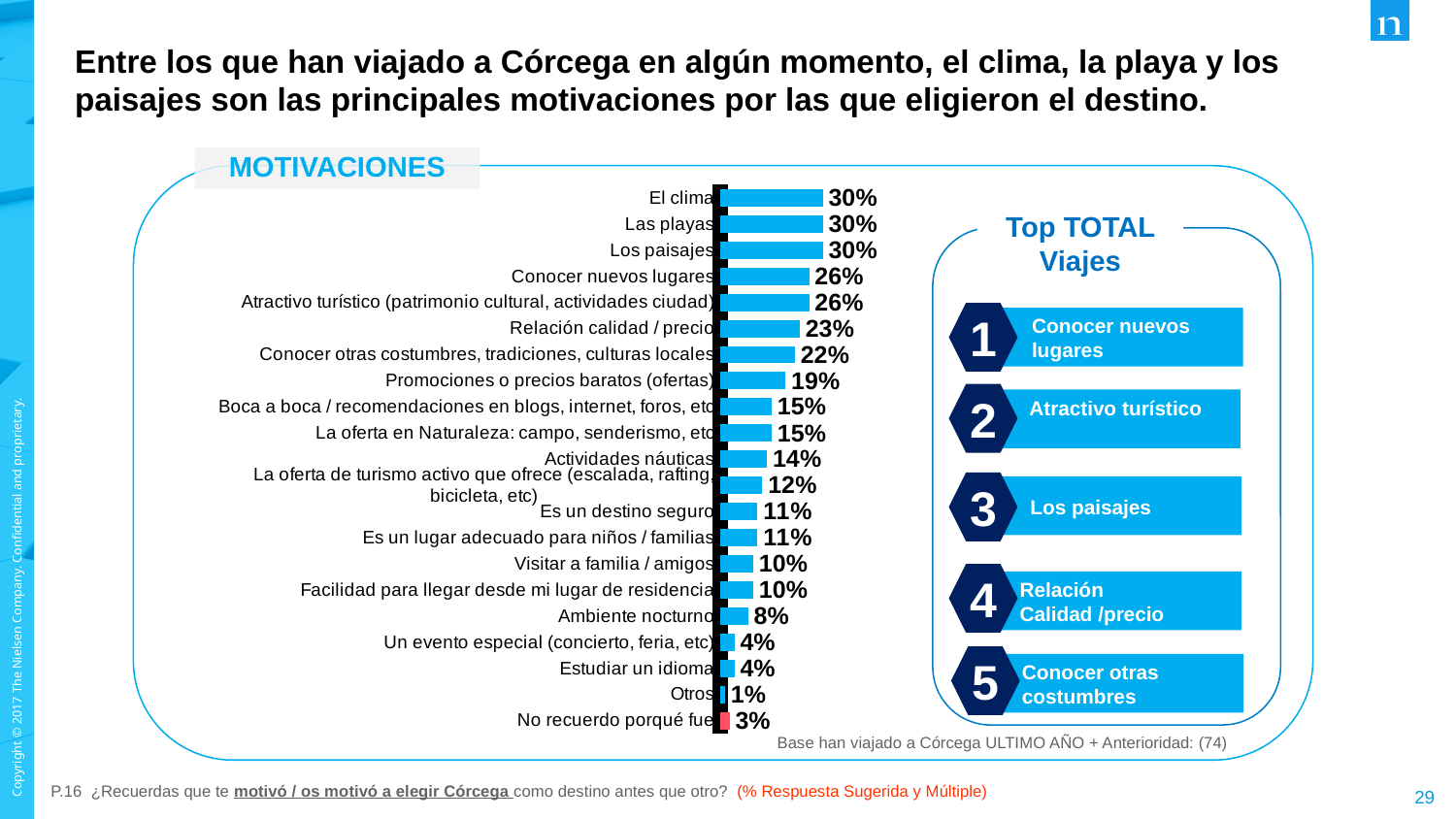
What is the difference between "El clima" and "Conocer otras costumbres, tradiciones, culturas locales"? 8% Which is larger, "Conocer nuevos lugares" or "Boca a boca / recomendaciones en blogs, internet, foros, etc"? Conocer nuevos lugares How many categories are shown in the bar chart? 21 What is the value for "Promociones o precios baratos (ofertas)"? 19% What kind of chart is shown on the slide? Bar chart What is the value for "Ambiente nocturno"? 8% What is the value for "No recuerdo porqué fue"? 3% What is the value for "Relación calidad / precio"? 23% What is the difference between "Actividades náuticas" and "Visitar a familia / amigos"? 4% Which category has the lowest value? Otros What is the value for "Estudiar un idioma"? 4% What is the title of the chart? MOTIVACIONES